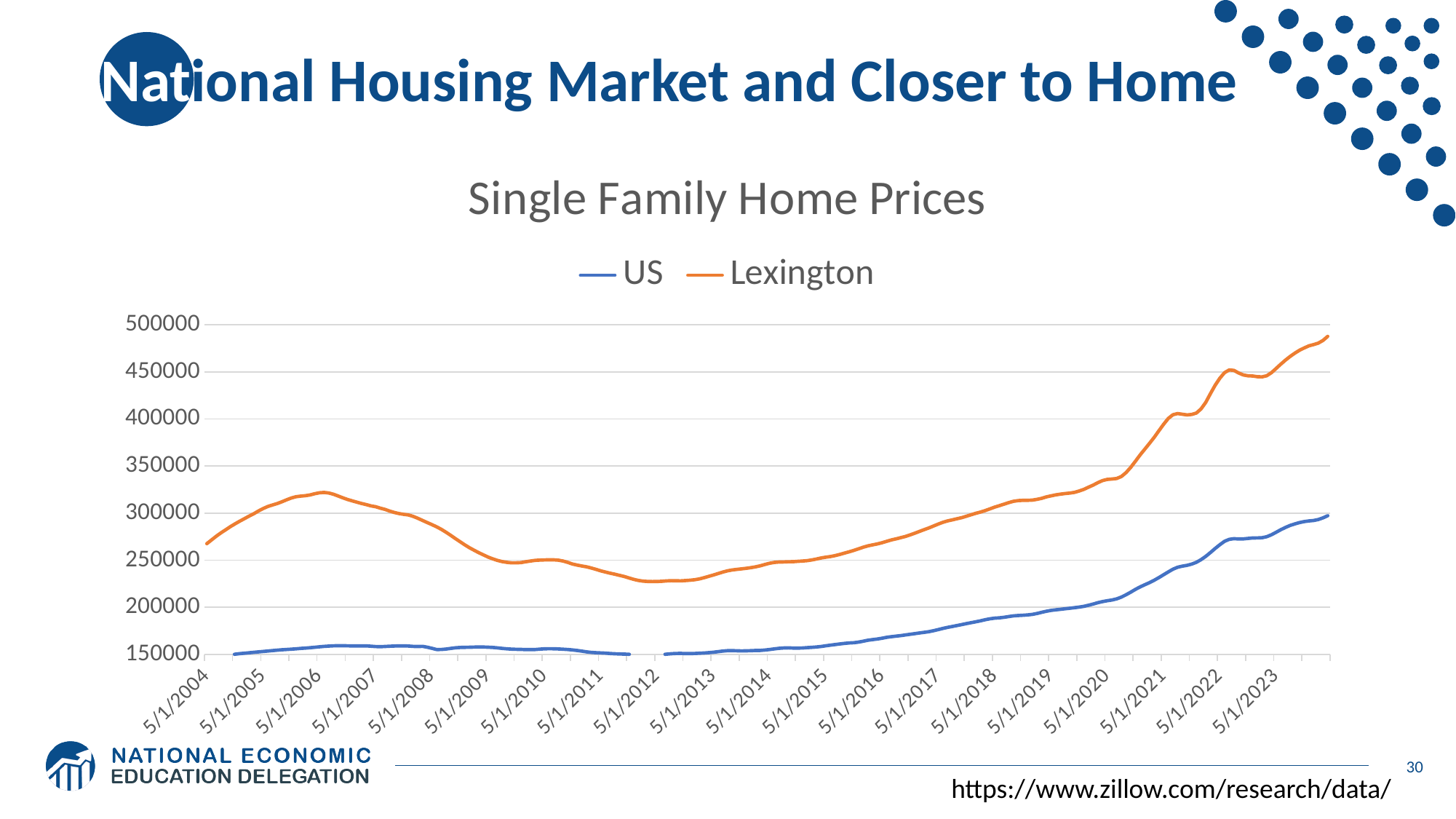
What kind of chart is shown on the slide? line chart How many series does the legend list? 2 Is the US value at 5/1/2023 greater or less than 300000? less Is the Lexington value at 5/1/2012 greater or less than 250000? less Which series is drawn in orange? Lexington What is the title of the chart? Single Family Home Prices Is the Lexington value at 5/1/2006 greater or less than 300000? greater At 5/1/2015, which series has the higher value, US or Lexington? Lexington Does the Lexington series rise or fall between 5/1/2006 and 5/1/2012? fall Does the US series rise or fall between 5/1/2012 and 5/1/2023? rise